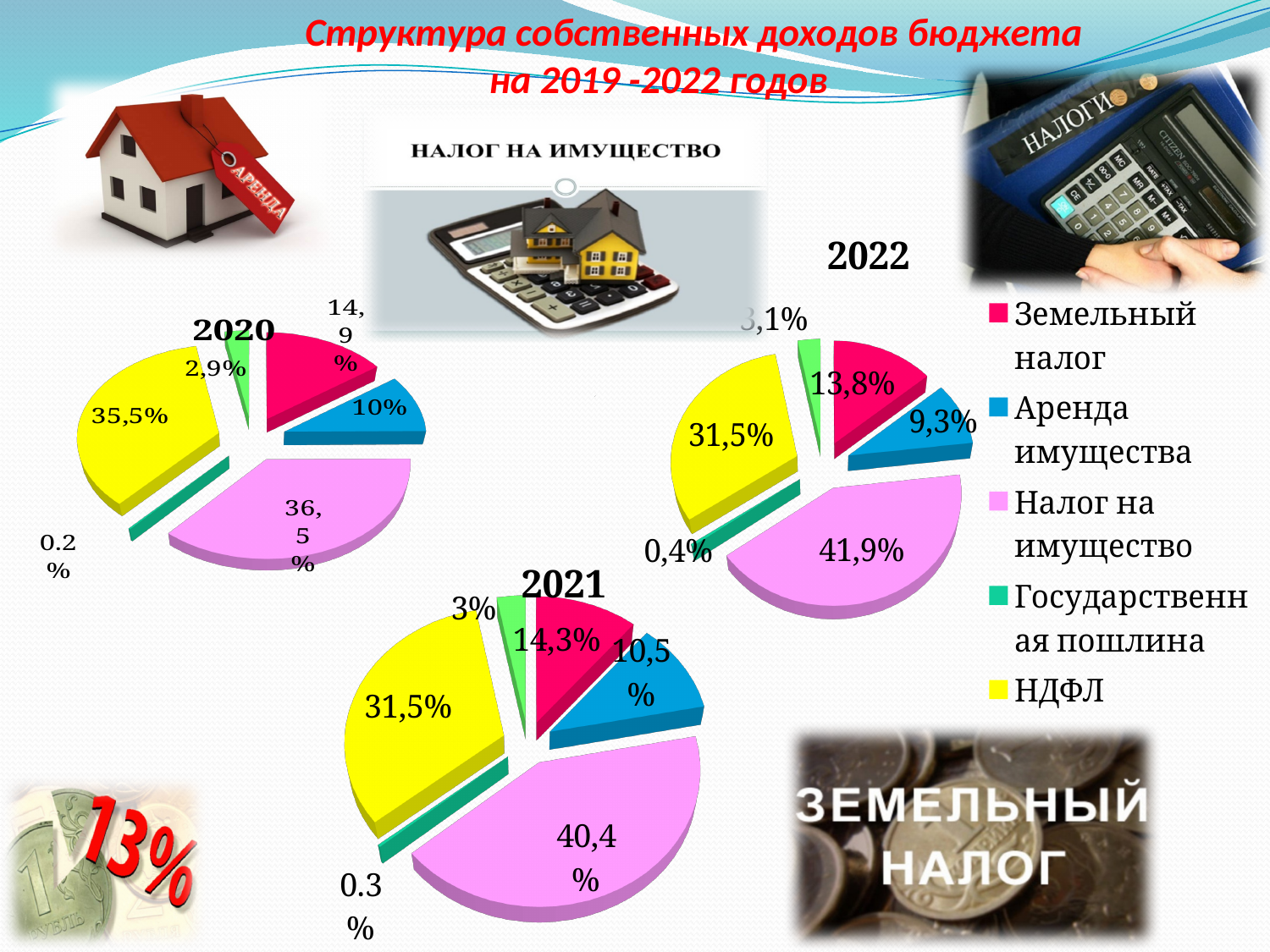
How many entries does the legend list? 5 In the 2020 pie chart, which is larger: Земельный налог or Аренда имущества? Земельный налог In the 2022 pie chart, which category has the smallest share? Государственная пошлина In the 2020 pie chart, what share is Аренда имущества? 10% In the 2022 pie chart, what share is Аренда имущества? 9,3% In the 2020 pie chart, what share is Налог на имущество? 36,5% In the 2021 pie chart, what share is Земельный налог? 14,3% In the 2022 pie chart, what is the difference between the shares of Налог на имущество and НДФЛ? 10,4% In the 2022 pie chart, what share is Налог на имущество? 41,9% In the 2021 pie chart, which category has the largest share? Налог на имущество What kind of charts are shown on the slide? Pie charts How many pie charts are on the slide? 3